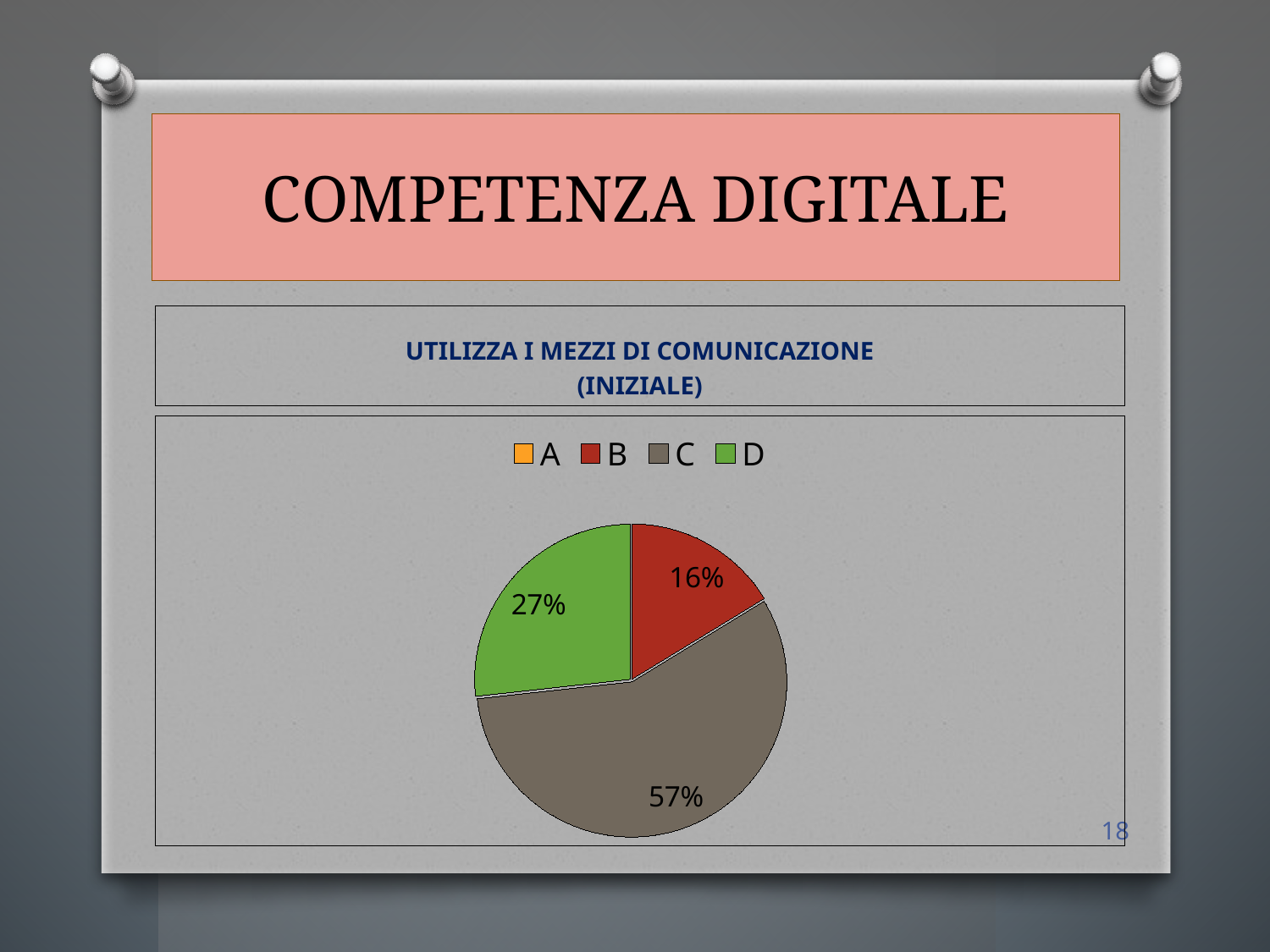
Which of the slices with a printed value is the smallest? B What percentage does slice D represent? 27% What is the title of the chart? UTILIZZA I MEZZI DI COMUNICAZIONE (INIZIALE) What is the difference in percentage points between slice C and slice B? 41 What percentage does slice C represent? 57% Which is larger, the slice for D or the slice for B? D How many entries does the legend list? 4 What colour is the slice for category C? grey What percentage does slice B represent? 16% Which category has the largest slice of the pie? C What kind of chart is shown on the slide? pie chart What is the difference in percentage points between slice C and slice D? 30